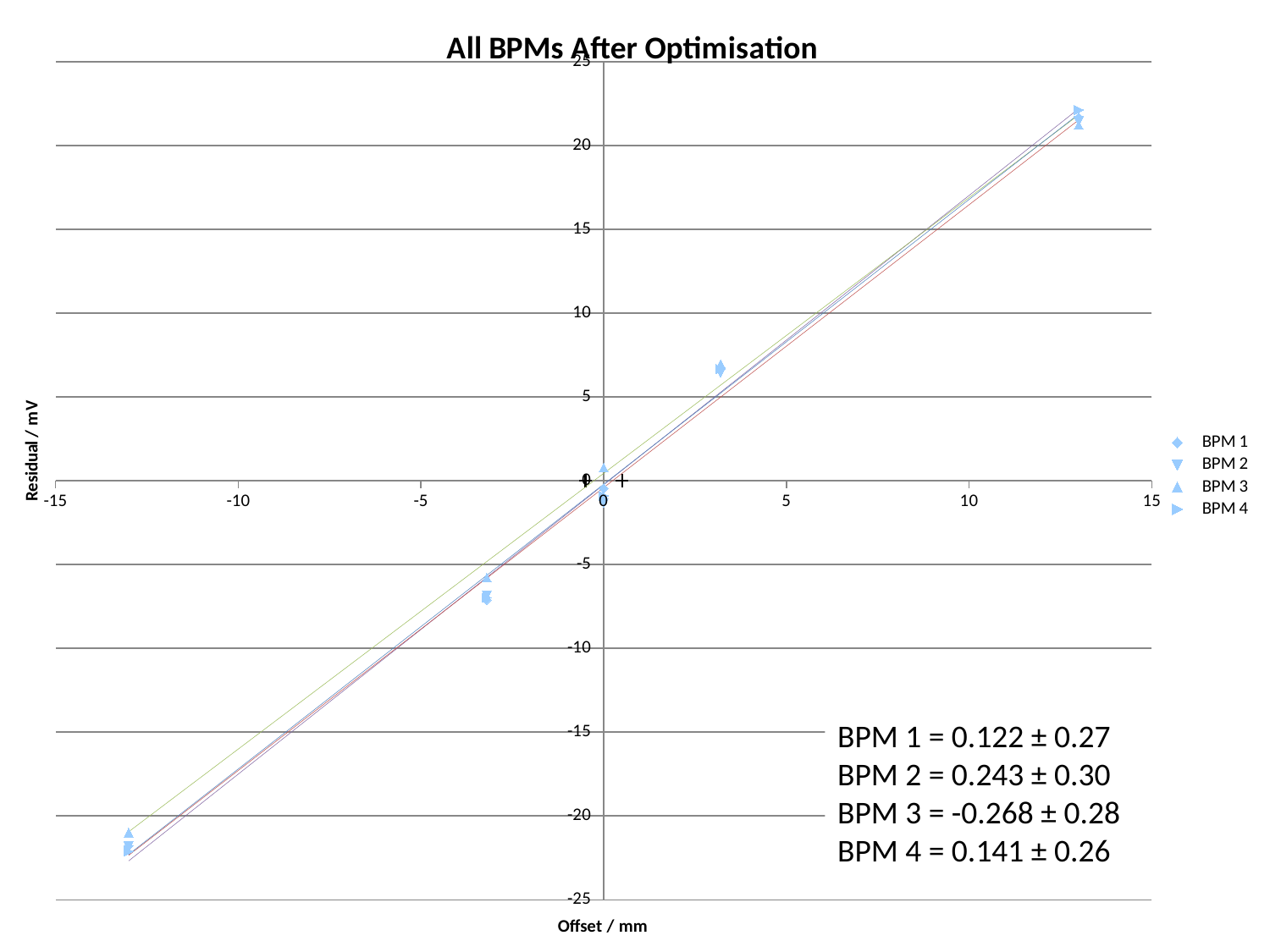
What is the title of the chart? All BPMs After Optimisation Is the residual value at an offset of about -3 mm greater or less than -5? less Is the residual value at an offset of about 13 mm greater or less than 20? greater Do the residual values rise or fall as the offset increases along the x axis? rise Which has the larger residual: the points at an offset of about 13 mm or the points at an offset of about 3 mm? offset of about 13 mm What kind of chart is shown on the slide? scatter chart Is the residual value at an offset of about 3 mm greater or less than 5? greater What is the label of the x axis? Offset / mm How many series does the legend list? 4 At how many distinct offset positions are data points plotted? 5